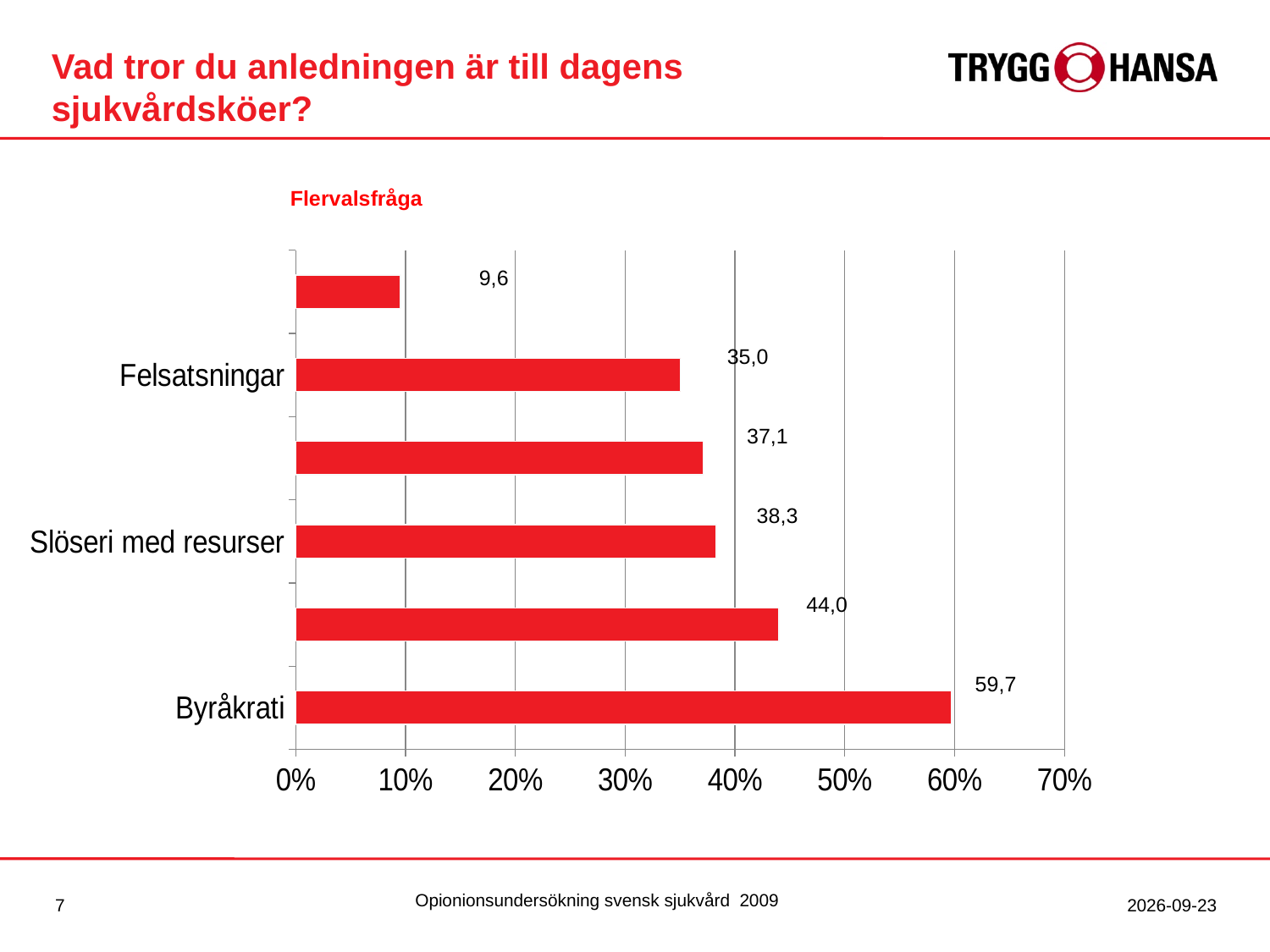
What is the difference between the values for Byråkrati and Felsatsningar? 24,7 Which is larger, the value for Slöseri med resurser or the value for Felsatsningar? Slöseri med resurser What is the value for Felsatsningar? 35,0 What is the value for Byråkrati? 59,7 What is the lowest value shown on the chart? 9,6 What is the value for Slöseri med resurser? 38,3 How many bars are plotted on the chart? 6 Is the value for Byråkrati greater or less than 50%? greater Which category has the highest value? Byråkrati What colour are the bars in the chart? red What type of chart is shown on the slide? bar chart What is the difference between the values for Slöseri med resurser and Felsatsningar? 3,3